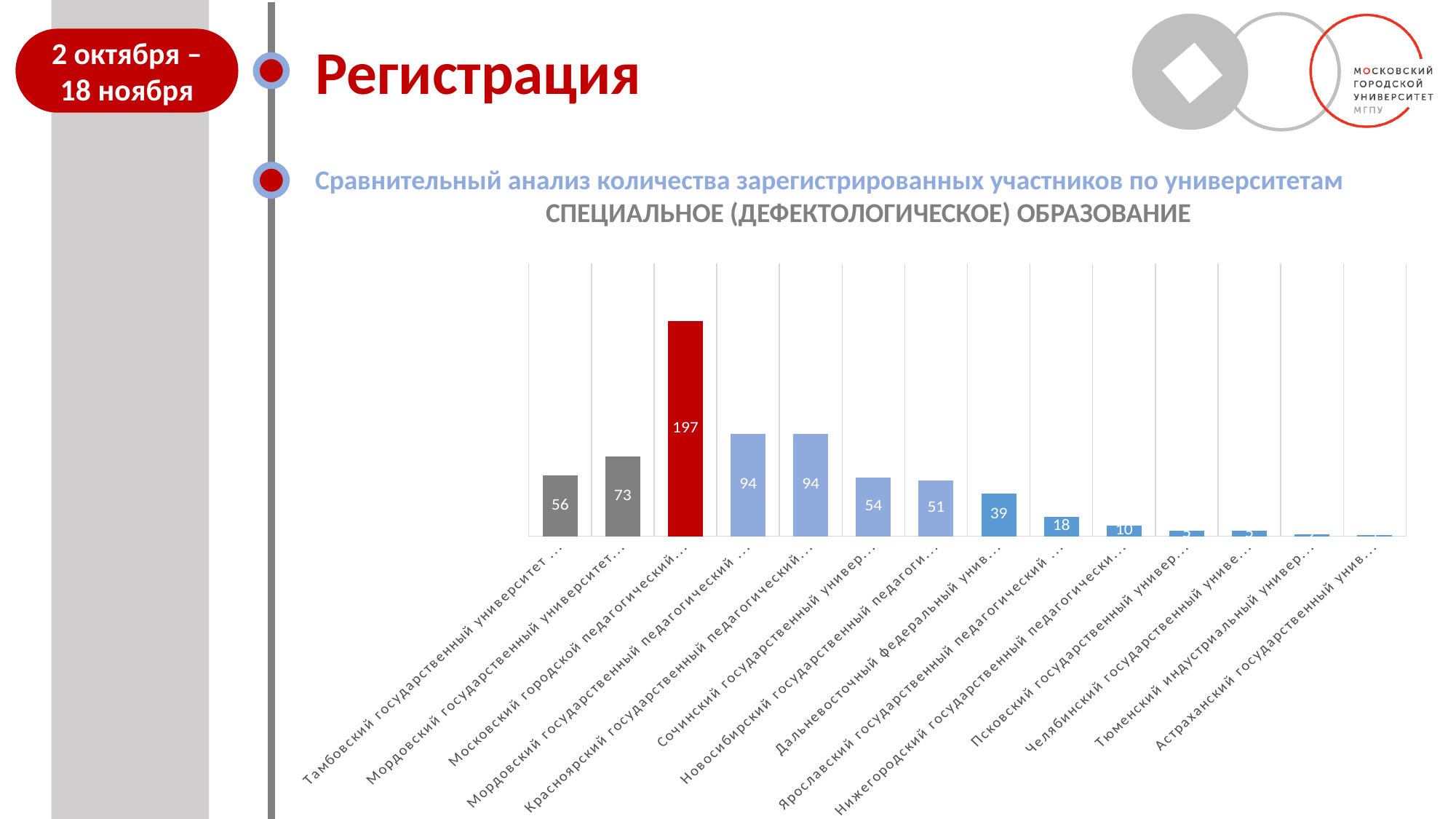
What value is shown for Ярославский государственный педагогический университет? 18 What colour is the bar for Московский городской педагогический университет? red How many universities (bars) are shown in the chart? 14 What value is shown for Московский городской педагогический университет? 197 What value is shown for Тамбовский государственный университет? 56 Which university has the highest number of registered participants? Московский городской педагогический университет What type of chart is shown on the slide? bar chart What is the difference between the values for Московский городской педагогический университет and Мордовский государственный педагогический университет? 103 Which is larger: the value for Новосибирский государственный педагогический университет or for Нижегородский государственный педагогический университет? Новосибирский государственный педагогический университет What value is shown for Сочинский государственный университет? 54 What is the difference between the values for Мордовский государственный университет and Тамбовский государственный университет? 17 What value is shown for Дальневосточный федеральный университет? 39